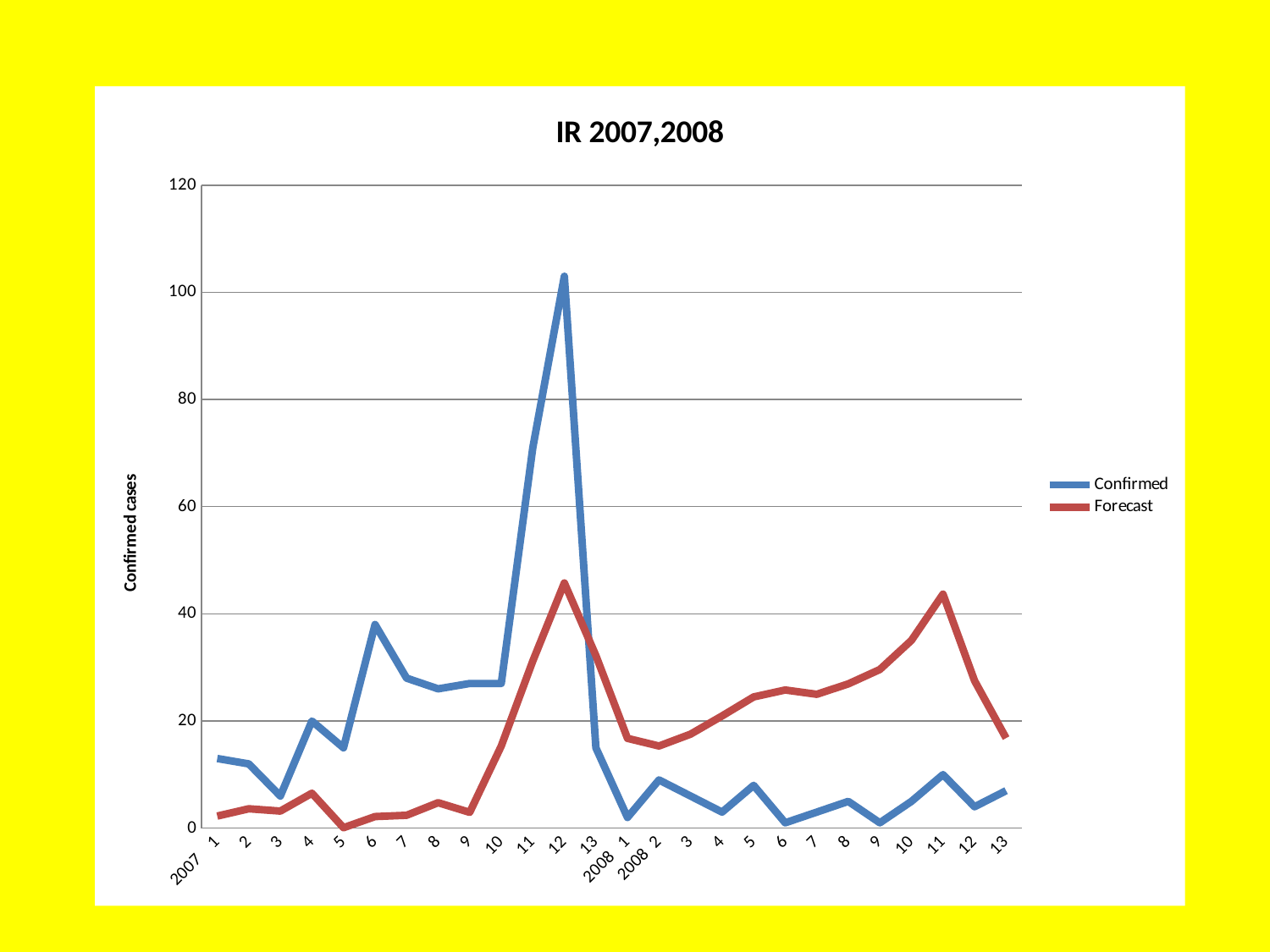
At 2008 period 5, which series has the larger value, Confirmed or Forecast? Forecast Is the Confirmed value at 2007 period 12 greater or less than 80? greater What is the title of the chart? IR 2007,2008 At which x-axis point does the Confirmed series reach its highest value? 2007 12 At which x-axis point does the Forecast series reach its lowest value? 2007 5 What is the label of the vertical axis? Confirmed cases Is the Forecast value at 2007 period 12 greater or less than 60? less What kind of chart is shown on the slide? line chart How many series does the legend list? 2 How many points are plotted along the x axis for each series? 26 Is the Confirmed value at 2007 period 6 greater or less than 20? greater Does the Forecast series rise or fall from 2008 period 1 to 2008 period 11? rise